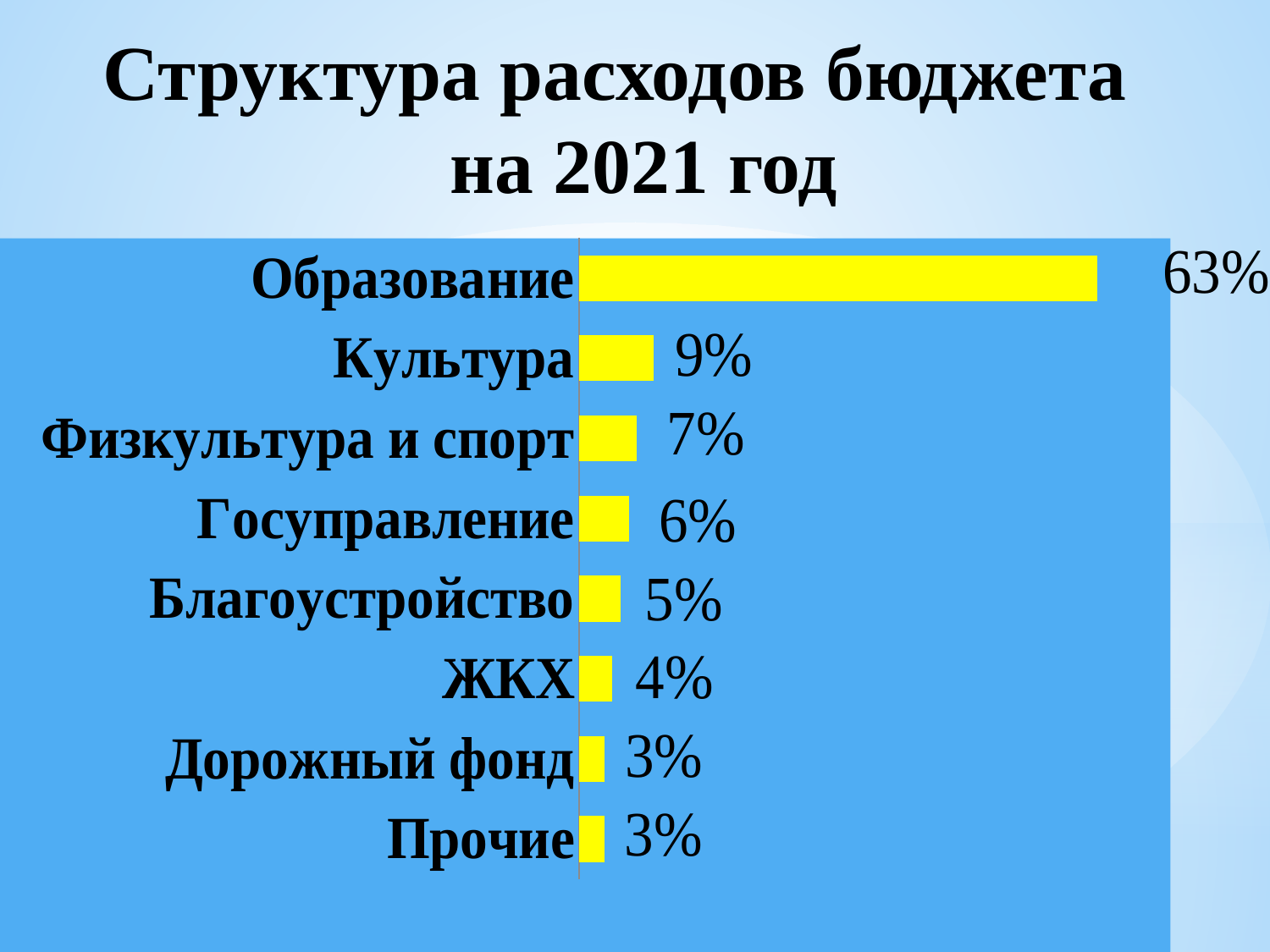
Which is larger, the value for Физкультура и спорт or the value for ЖКХ? Физкультура и спорт What is the value for Образование? 63% How many categories are shown in the chart? 8 What kind of chart is shown on the slide? bar chart What is the title of the slide? Структура расходов бюджета на 2021 год What is the difference between the values for Госуправление and Благоустройство? 1% What is the value for Культура? 9% What is the value for Физкультура и спорт? 7% What is the difference between the values for Образование and Культура? 54% What colour are the bars in the chart? yellow What is the value for ЖКХ? 4% Which category has the highest value? Образование